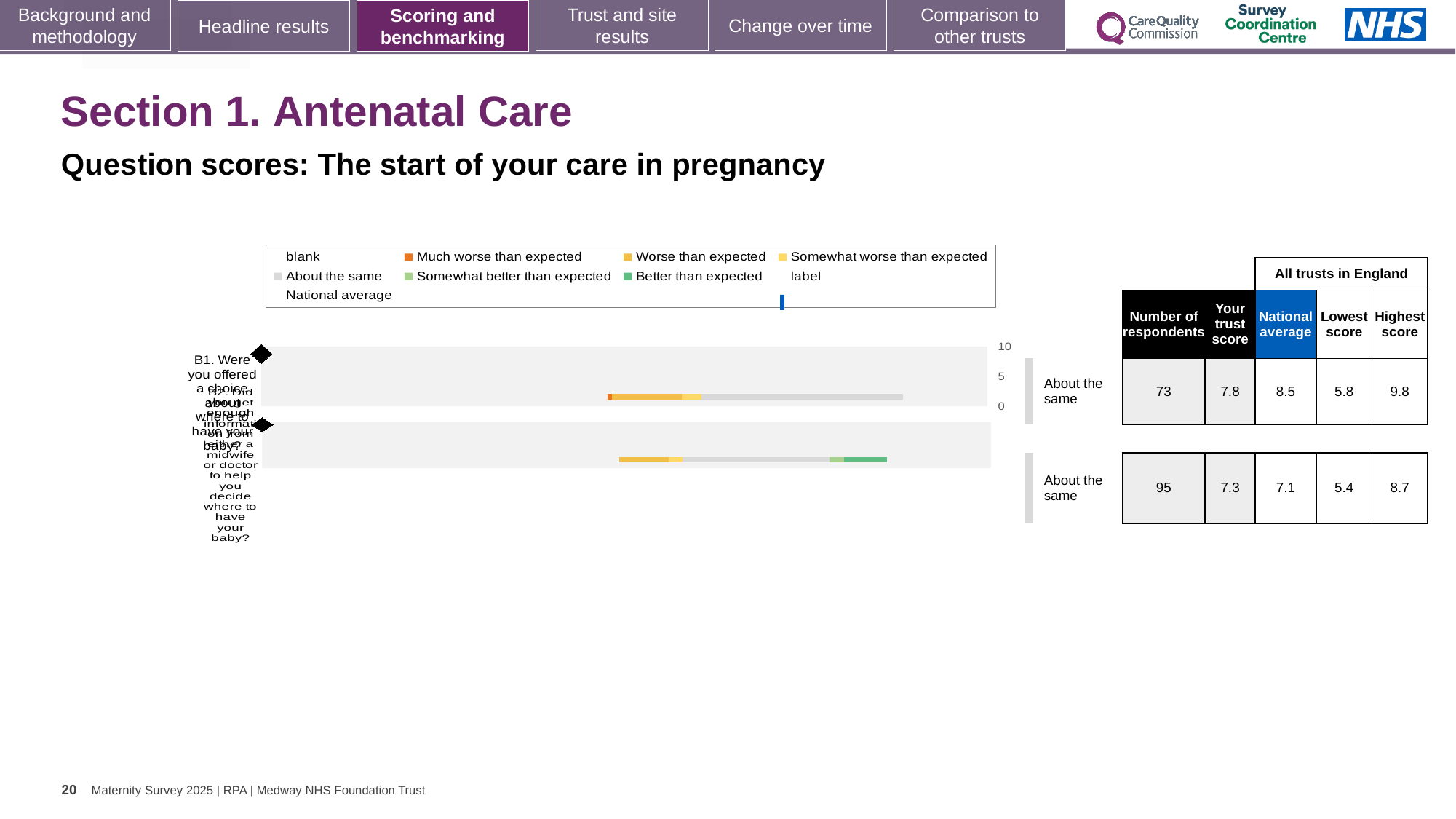
For question B2, which is larger: the trust score or the National average? Your trust score For question B1, which is larger: the trust score or the National average? National average How many respondents answered question B2? 95 How many survey questions (categories) are plotted in the chart? 2 Which question had the greater number of respondents, B1 or B2? B2 What is the Highest score among all trusts in England for question B2? 8.7 What kind of chart is shown on the slide? bar chart What is the difference between the Highest score and the Lowest score for question B1? 4.0 What is the National average score for question B1? 8.5 What is the 'Your trust score' for question B1 (Were you offered a choice about where to have your baby?)? 7.8 What benchmark category label is shown next to the bar for question B1? About the same